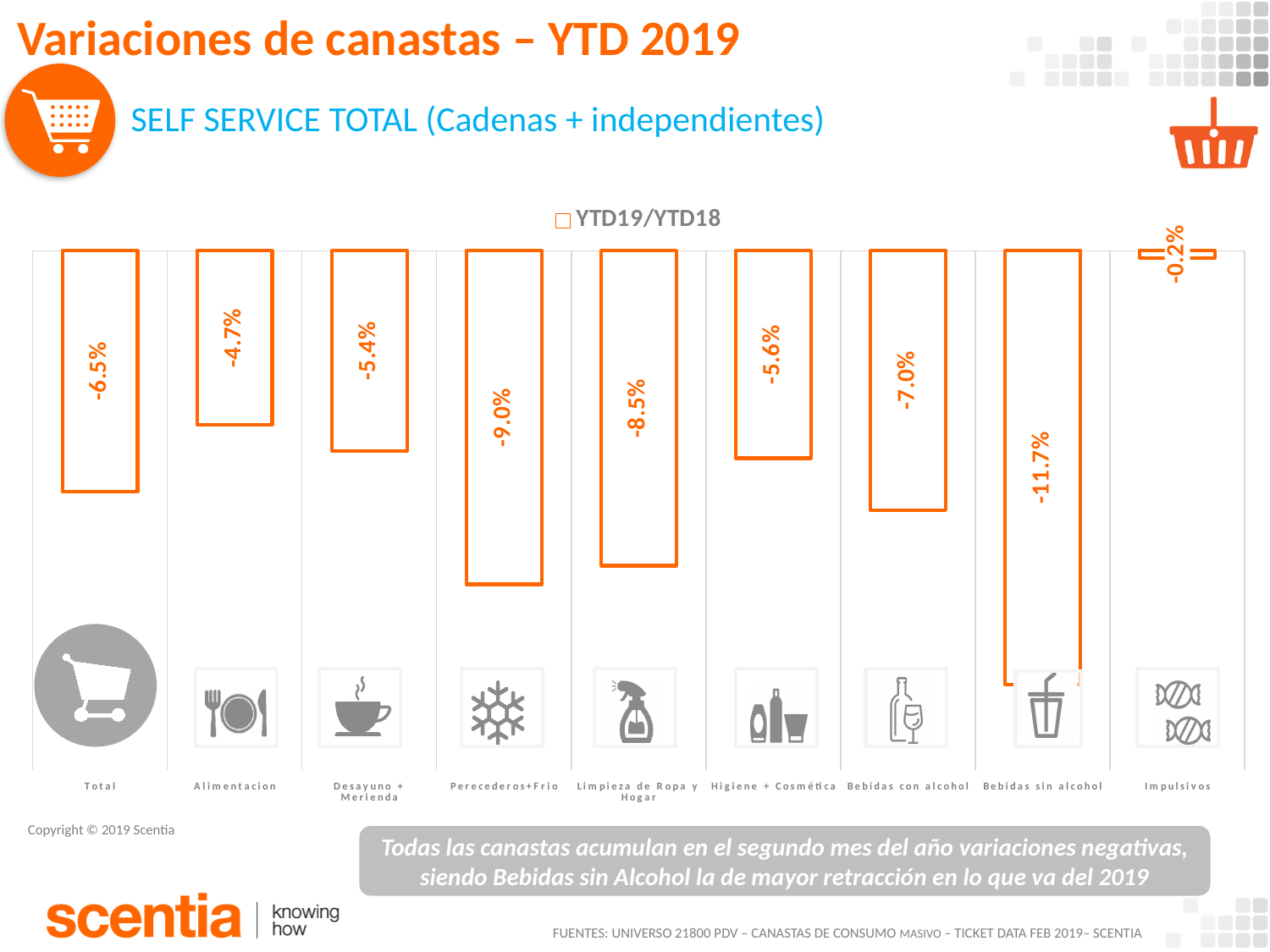
What is the legend entry of the chart? YTD19/YTD18 Which has a larger (less negative) value, Higiene + Cosmética or Bebidas con alcohol? Higiene + Cosmética How many categories are shown in the chart? 9 What is the YTD19/YTD18 variation for Total? -6.5% Which category shows the largest decline (lowest value)? Bebidas sin alcohol How many series does the legend list? 1 What is the difference between the values for Perecederos+Frio and Limpieza de Ropa y Hogar? 0.5 percentage points What is the YTD19/YTD18 variation for Bebidas sin alcohol? -11.7% What kind of chart is shown on the slide? Bar chart What is the YTD19/YTD18 variation for Alimentacion? -4.7% Which category has the highest value (smallest decline)? Impulsivos What is the YTD19/YTD18 variation for Perecederos+Frio? -9.0%